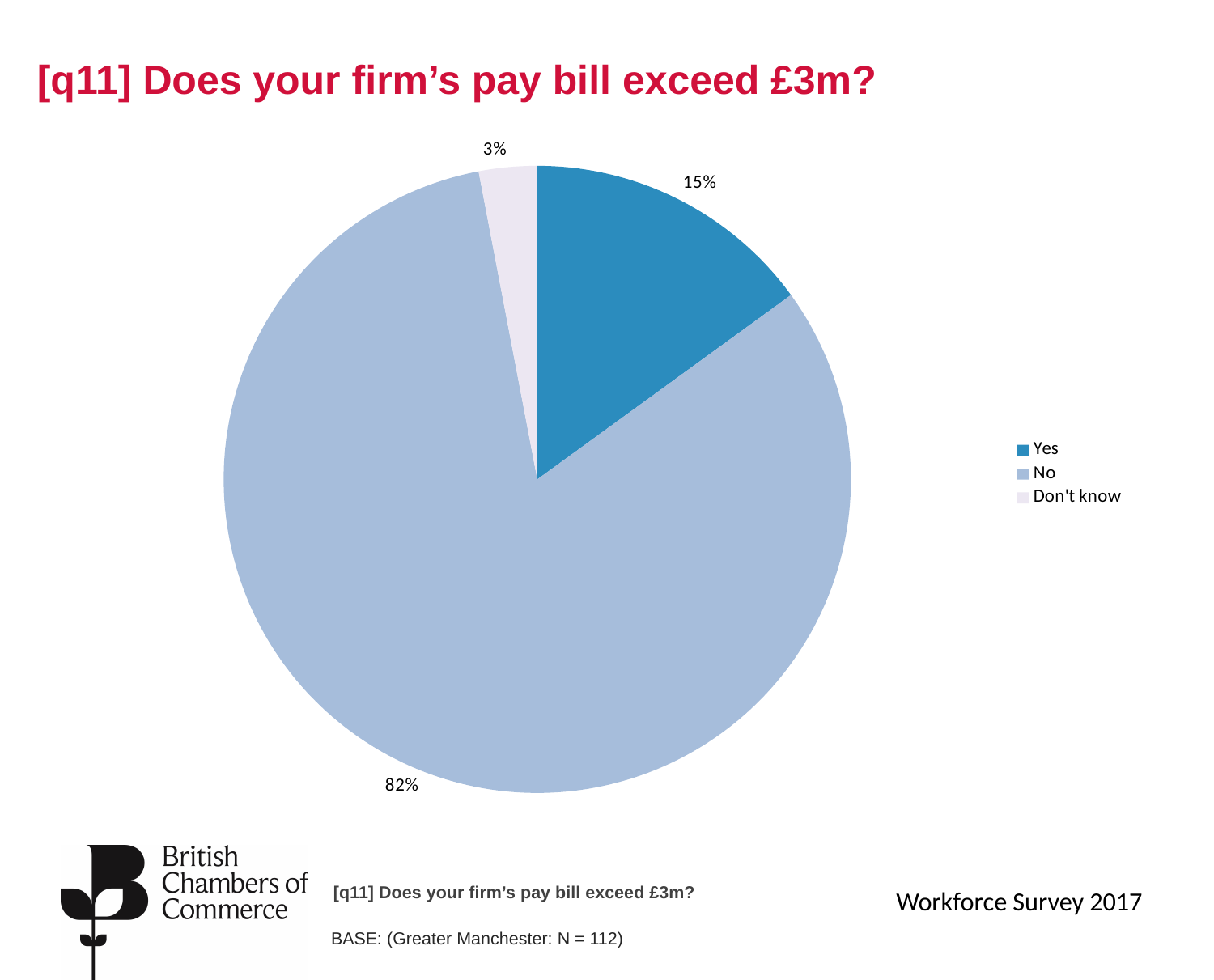
Which is larger, the "Yes" share or the "Don't know" share? Yes How many slices does the pie chart have? 3 What percentage of firms answered "Yes" to whether their pay bill exceeds £3m? 15% How many entries does the legend list? 3 Which response has the smallest share of the pie? Don't know What is the base sample size stated on the slide? N = 112 What is the difference in percentage points between the "No" and "Yes" shares? 67 What percentage of firms answered "Don't know"? 3% Which legend entry is shown in the darkest blue colour? Yes Which response has the largest share of the pie? No What percentage of firms answered "No"? 82% What kind of chart is shown on the slide? Pie chart